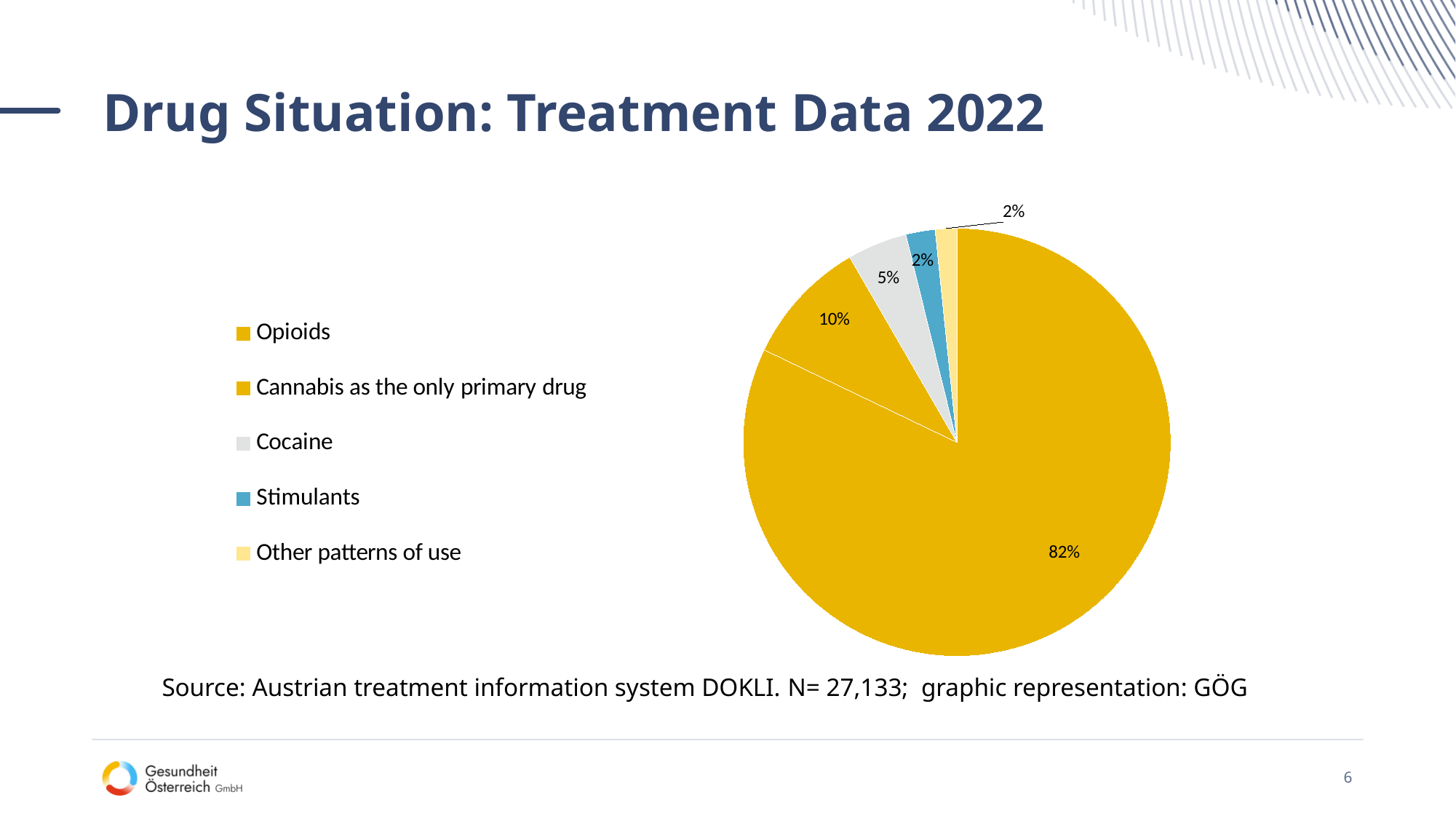
What is the title of the slide containing the chart? Drug Situation: Treatment Data 2022 What is the difference in percentage points between the Opioids slice and the Cannabis as the only primary drug slice? 72 What is the difference in percentage points between the Cocaine slice and the Stimulants slice? 3 What kind of chart is shown on the slide? pie chart What colour is the Stimulants slice in the pie chart? blue What share of the pie does Cocaine account for? 5% Which slice is larger, Cocaine or Cannabis as the only primary drug? Cannabis as the only primary drug Which category has the largest slice of the pie? Opioids What share of the pie does Cannabis as the only primary drug account for? 10% What share of the pie does Stimulants account for? 2% How many categories does the legend list? 5